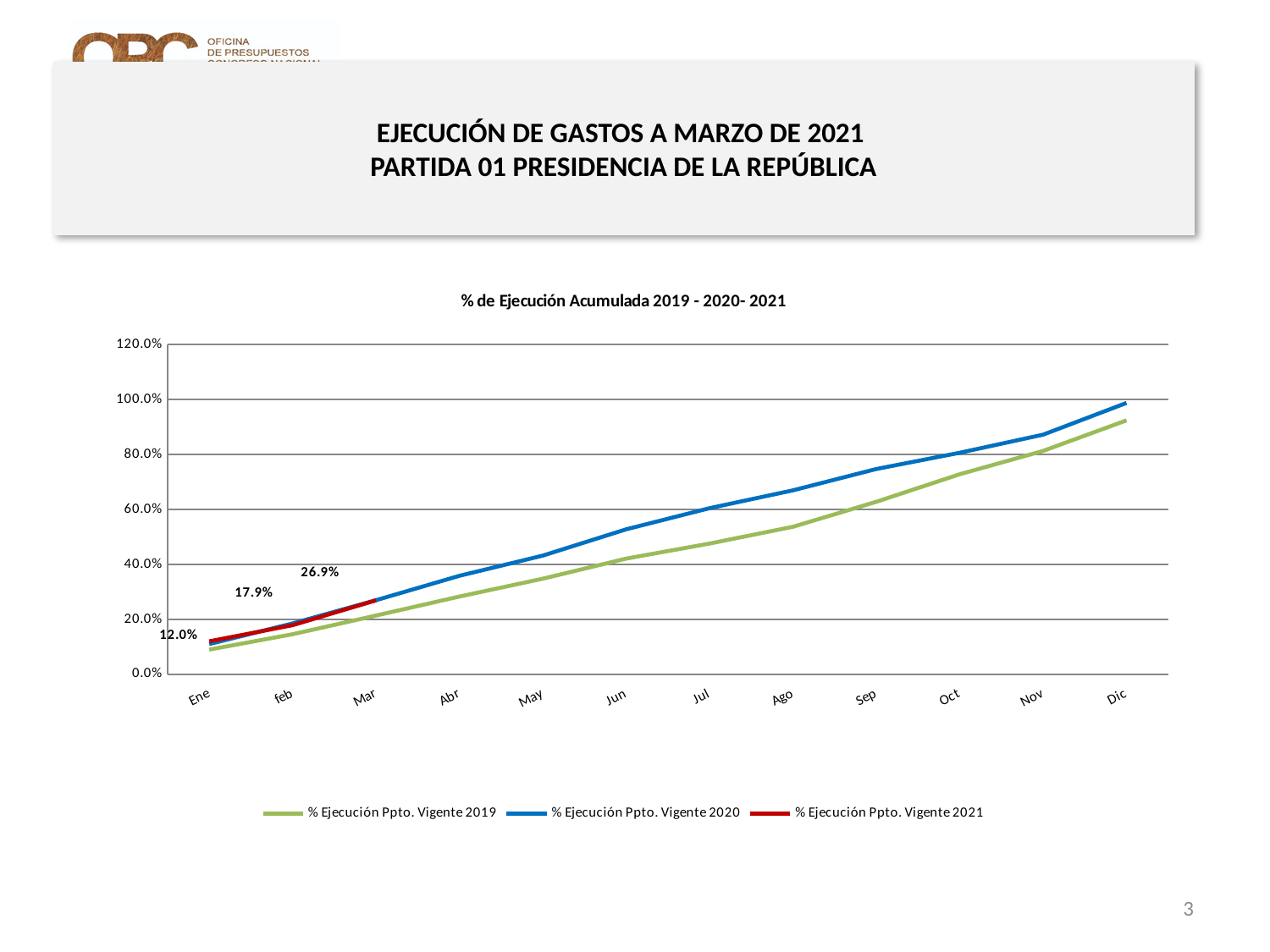
What is the difference between the 2021 values for Mar and Feb? 9.0% What is the value of % Ejecución Ppto. Vigente 2021 for Feb? 17.9% Is the value for % Ejecución Ppto. Vigente 2020 in Dic greater or less than 80.0%? greater In Dic, which series is higher: % Ejecución Ppto. Vigente 2019 or % Ejecución Ppto. Vigente 2020? % Ejecución Ppto. Vigente 2020 What kind of chart is shown on the slide? line chart How many months are shown on the x axis? 12 What is the title of the chart? % de Ejecución Acumulada 2019 - 2020- 2021 What is the difference between the 2021 values for Feb and Ene? 5.9% Do the values for % Ejecución Ppto. Vigente 2020 rise or fall from Ene to Dic? rise What is the value of % Ejecución Ppto. Vigente 2021 for Mar? 26.9% What is the value of % Ejecución Ppto. Vigente 2021 for Ene? 12.0% How many series does the legend list? 3